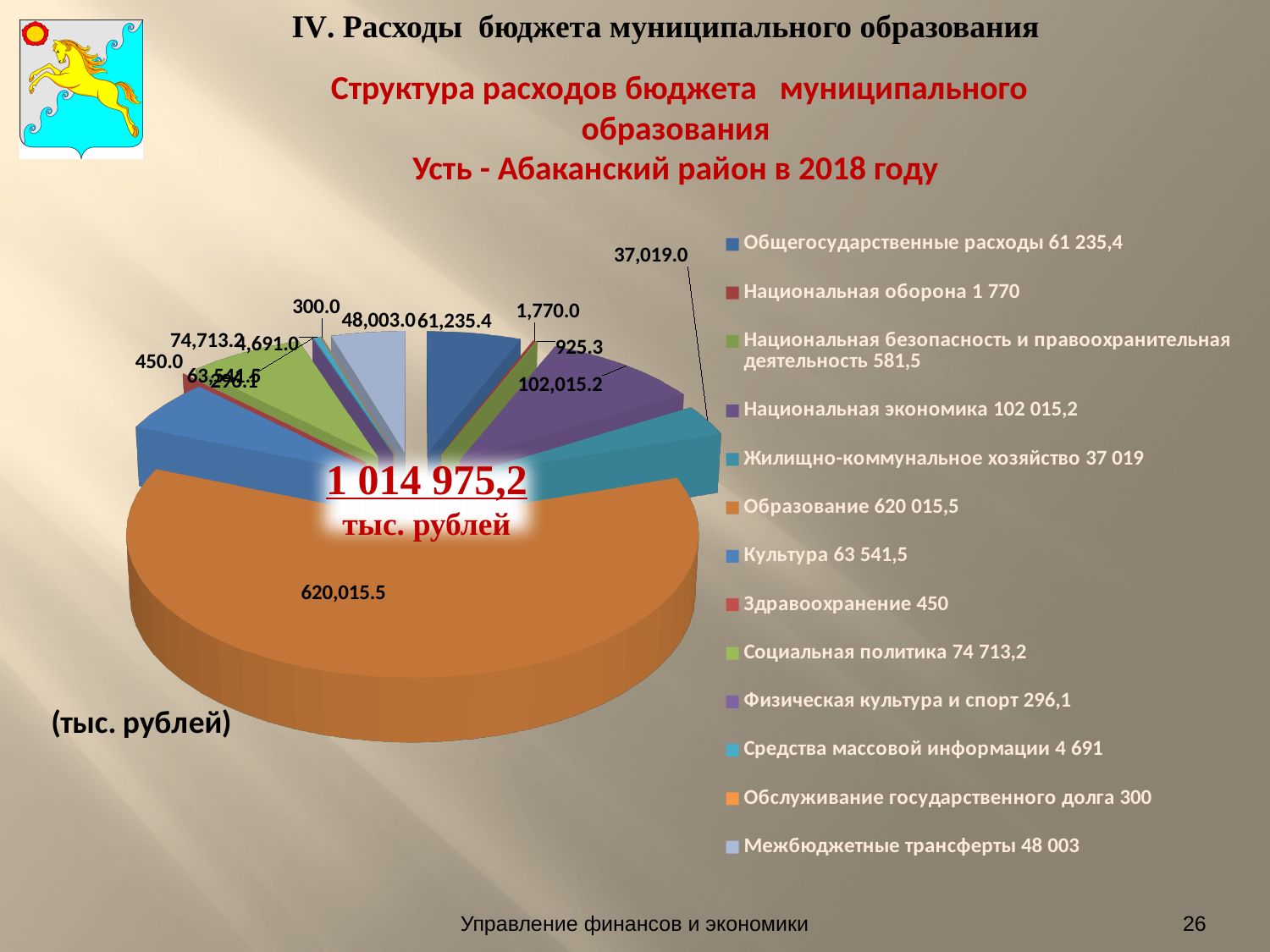
Which is larger, the value for Социальная политика or the value for Культура? Социальная политика What kind of chart is shown on the slide? Pie chart How many expenditure categories does the legend of the pie chart list? 13 Which expenditure category has the largest slice of the pie chart? Образование Which expenditure category has the smallest value in the legend? Физическая культура и спорт What is the value for Межбюджетные трансферты? 48 003 What is the value for Национальная экономика? 102 015,2 What is the value for Культура? 63 541,5 What is the difference between the values for Образование and Национальная экономика? 518 000,3 What is the value for Жилищно-коммунальное хозяйство? 37 019 What total amount of expenditures is printed in the centre of the pie chart? 1 014 975,2 тыс. рублей For which year does the chart show the structure of budget expenditures? 2018